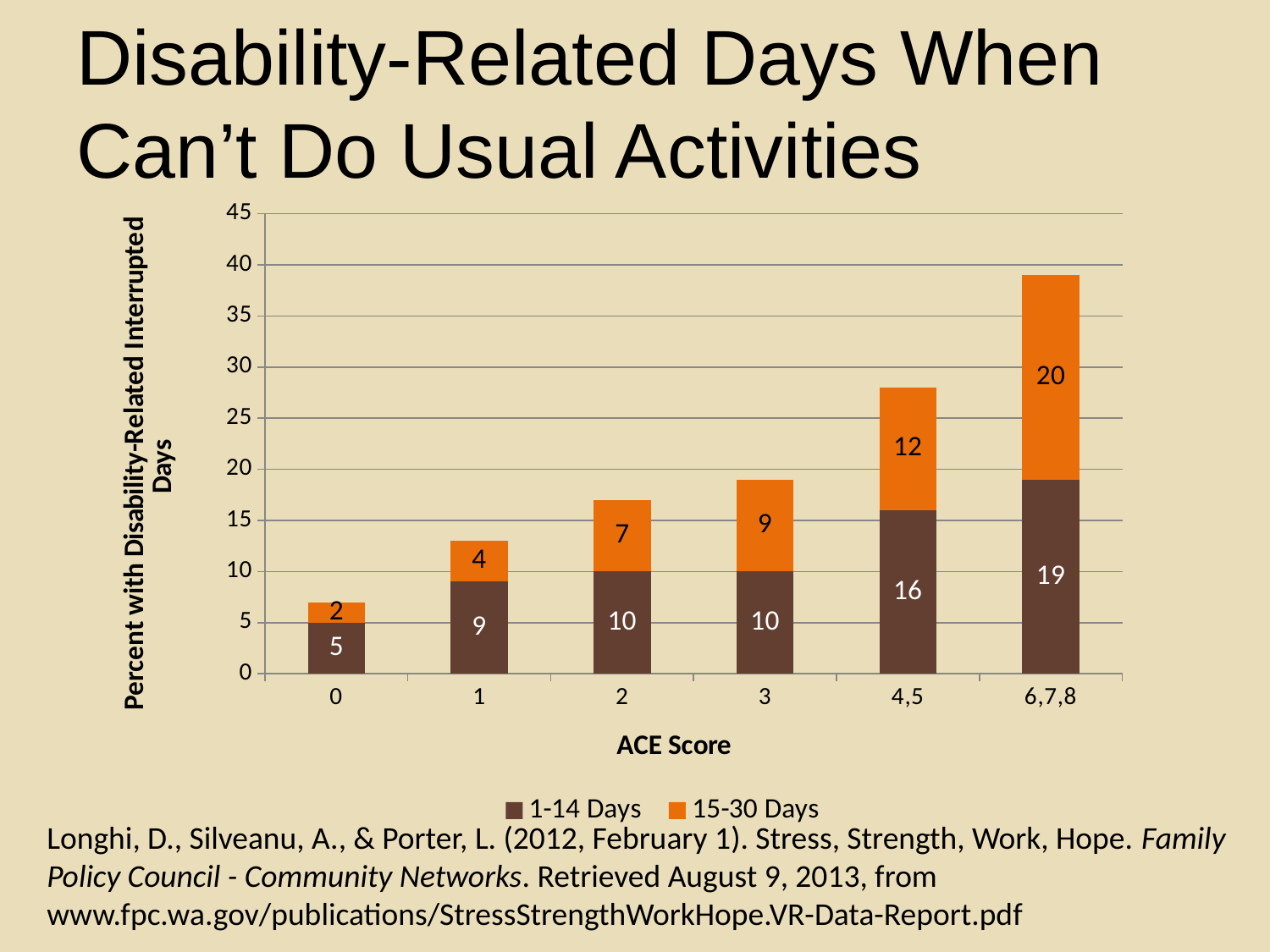
How many ACE Score categories are shown on the x axis? 6 Which is larger: the 15-30 Days value at ACE Score 3 or at ACE Score 2? ACE Score 3 Which ACE Score category has the highest value for the 1-14 Days series? 6,7,8 What is the value for the 1-14 Days series at ACE Score 0? 5 Do the total bar heights rise or fall as the ACE Score increases along the x axis? rise How many series does the legend list? 2 What is the total height of the stacked bar for ACE Score 4,5? 28 What is the total height of the stacked bar for ACE Score 6,7,8? 39 Which ACE Score category has the lowest value for the 15-30 Days series? 0 What is the value for the 15-30 Days series at ACE Score 6,7,8? 20 What is the value for the 15-30 Days series at ACE Score 4,5? 12 What is the difference between the 1-14 Days values for ACE Score 4,5 and ACE Score 1? 7